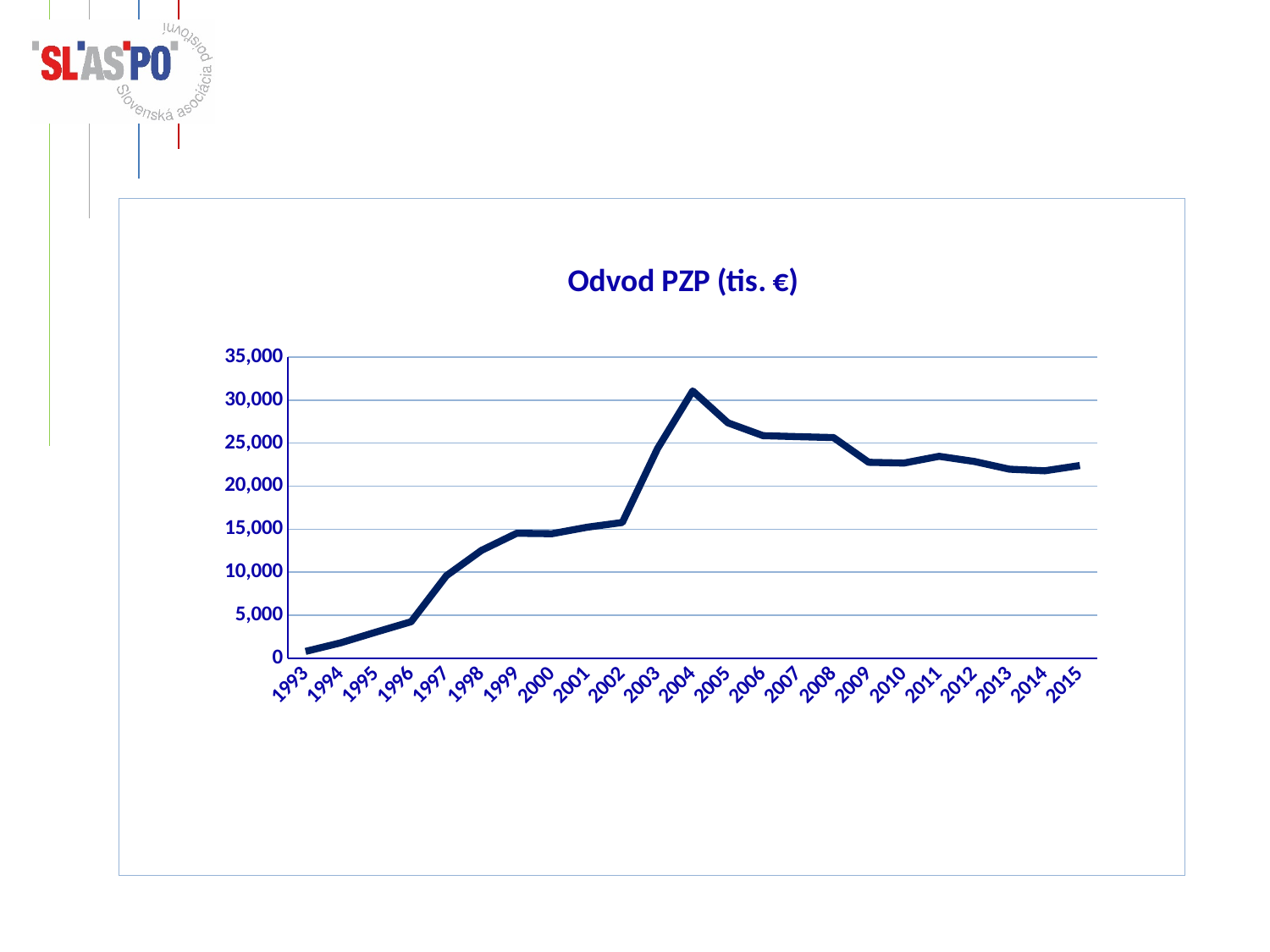
How many years are plotted on the x axis of the chart? 23 Is the value for 2015 greater or less than 20,000? greater Is the value for 2009 greater or less than 25,000? less What is the title of the chart? Odvod PZP (tis. €) Do the values generally rise or fall between 2004 and 2009? fall Which year has the larger value, 2005 or 2010? 2005 Do the values generally rise or fall between 1993 and 2004? rise In which year does the line reach its highest value? 2004 In which year is the value lowest? 1993 Is the value for 2004 greater or less than 30,000? greater What kind of chart is shown on the slide? line chart